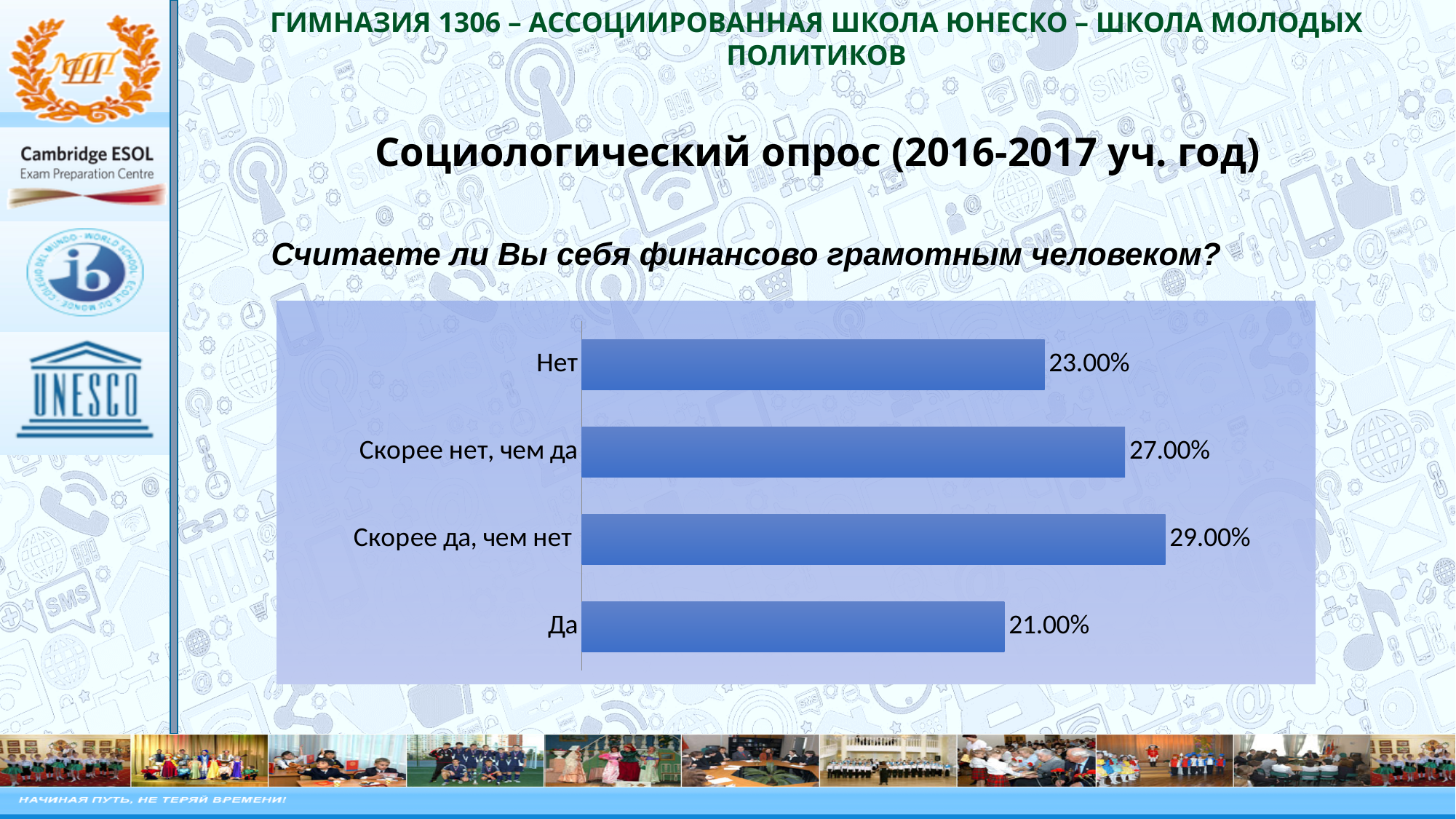
What is the difference between the values for "Скорее нет, чем да" and "Нет"? 4.00% What kind of chart is shown on the slide? Bar chart How many categories are shown in the chart? 4 Which category has the highest value? Скорее да, чем нет Which is larger, the value for "Нет" or the value for "Да"? Нет What is the difference between the values for "Скорее да, чем нет" and "Да"? 8.00% What is the value for "Нет"? 23.00% What is the value for "Да"? 21.00% What question does the chart answer, as written above it? Считаете ли Вы себя финансово грамотным человеком? What is the value for "Скорее нет, чем да"? 27.00% What is the value for "Скорее да, чем нет"? 29.00% Which category has the lowest value? Да